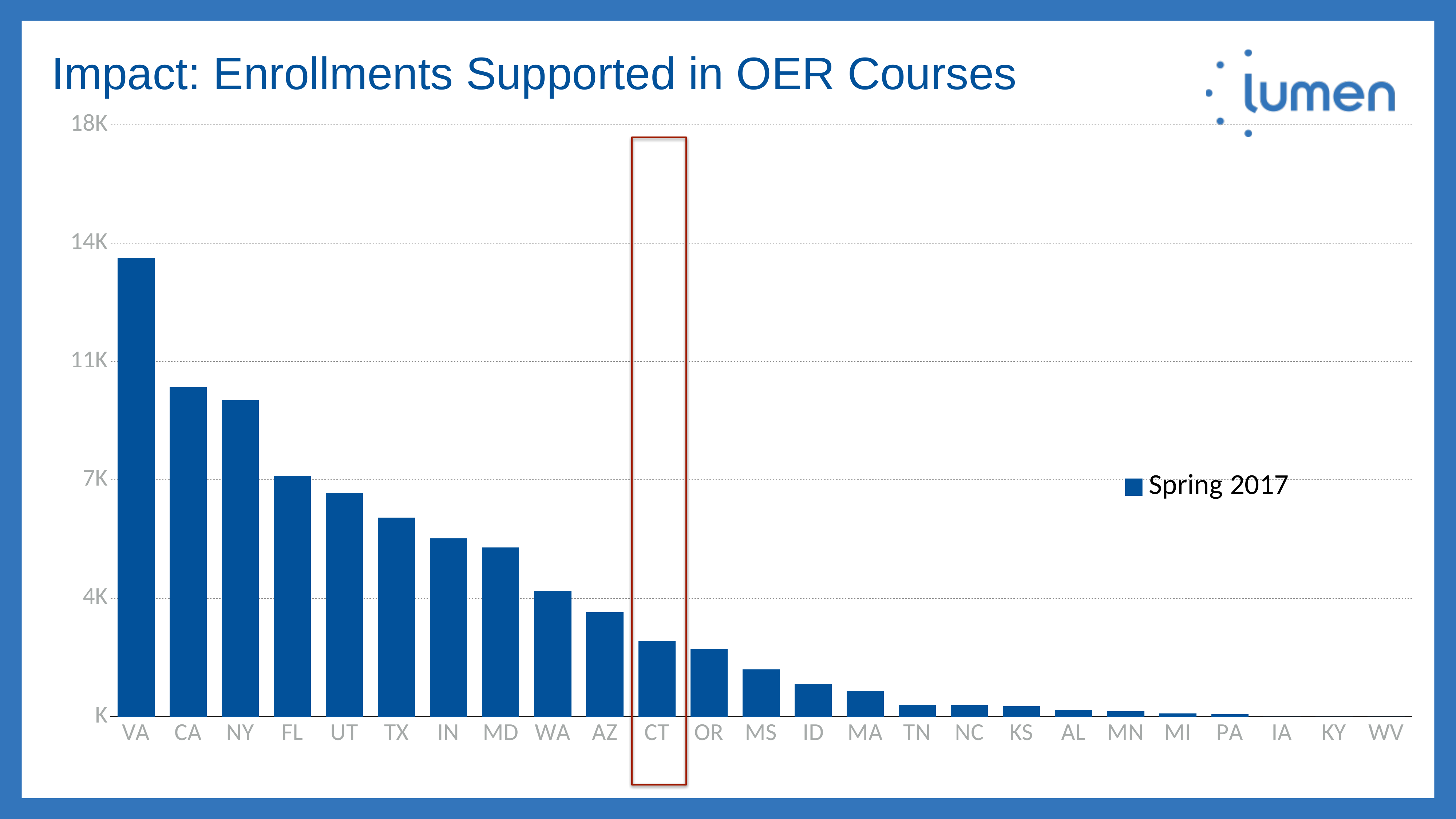
Which has a larger value, TX or IN? TX Which has a larger value, MD or WA? MD How many states are shown along the x axis? 25 Do the values rise or fall moving from left to right along the x axis? Fall Is the value for AZ greater or less than 4K? less Which state's bar is outlined with a red box? CT Is the value for VA greater or less than 11K? greater Is the value for CA greater or less than 11K? less How many series does the legend list? 1 What kind of chart is shown on the slide? Bar chart Which state has the highest number of enrollments? VA